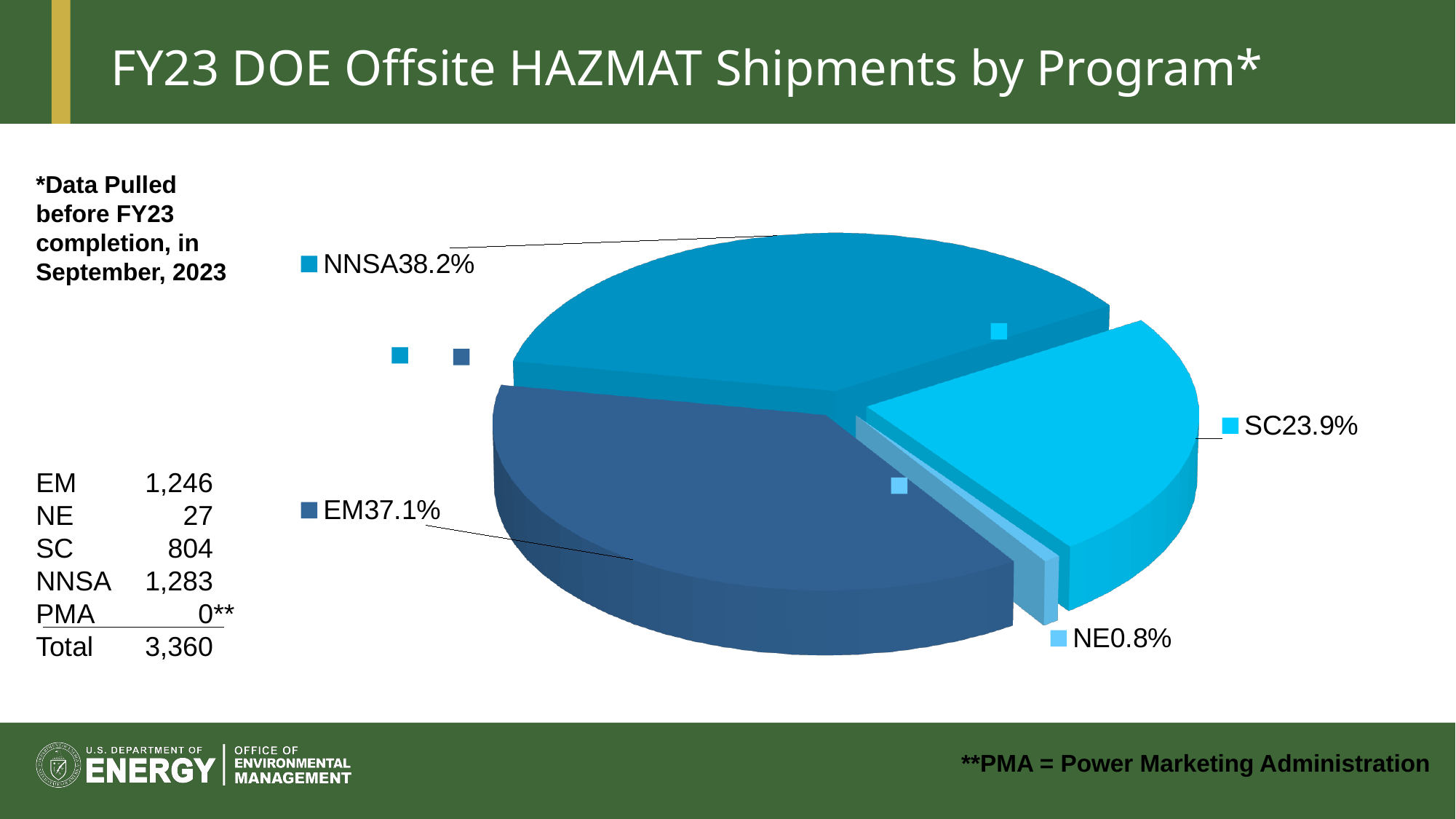
What kind of chart is shown on the slide? pie chart What is the difference in percentage points between the SC slice and the NE slice? 23.1 percentage points How many labeled slices does the pie chart have? 4 What share of the pie does NE account for? 0.8% Which program has the largest slice of the pie? NNSA What is the difference in percentage points between the NNSA slice and the EM slice? 1.1 percentage points What share of the pie does NNSA account for? 38.2% What share of the pie does SC account for? 23.9% What is the title of the slide containing the pie chart? FY23 DOE Offsite HAZMAT Shipments by Program* Which program has the smallest slice of the pie? NE Which slice is larger, EM or SC? EM